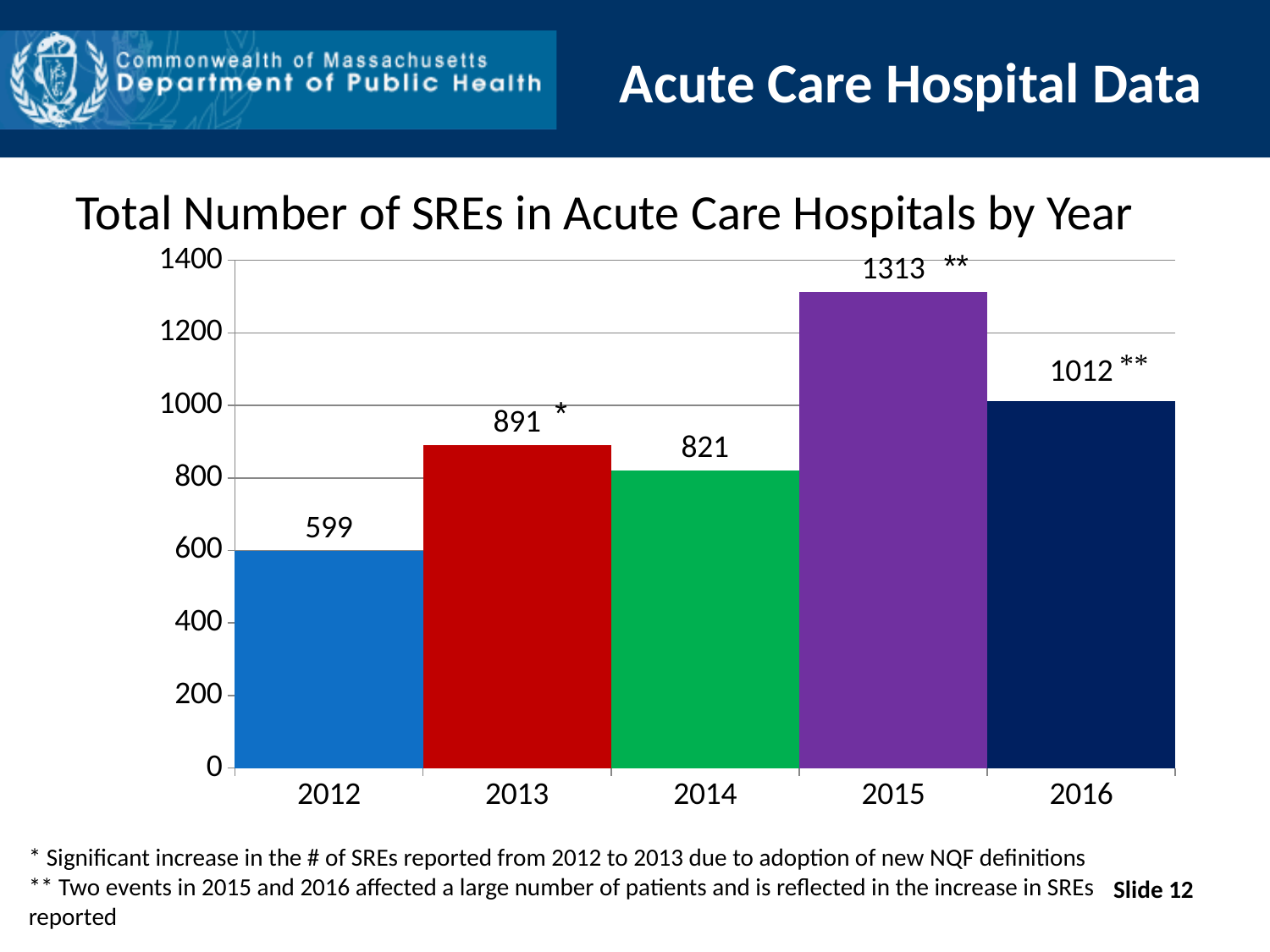
What is the title of the chart? Total Number of SREs in Acute Care Hospitals by Year What is the difference between the number of SREs in 2015 and in 2016? 301 How many years are shown on the chart? 5 What is the total number of SREs in acute care hospitals in 2012? 599 Which year had more SREs, 2013 or 2014? 2013 What is the difference between the number of SREs in 2013 and in 2014? 70 Which year has the highest total number of SREs? 2015 What kind of chart is shown on the slide? bar chart Which year has the lowest total number of SREs? 2012 Is the value for 2014 greater or less than 1000? less What is the total number of SREs in acute care hospitals in 2015? 1313 What is the total number of SREs in acute care hospitals in 2016? 1012